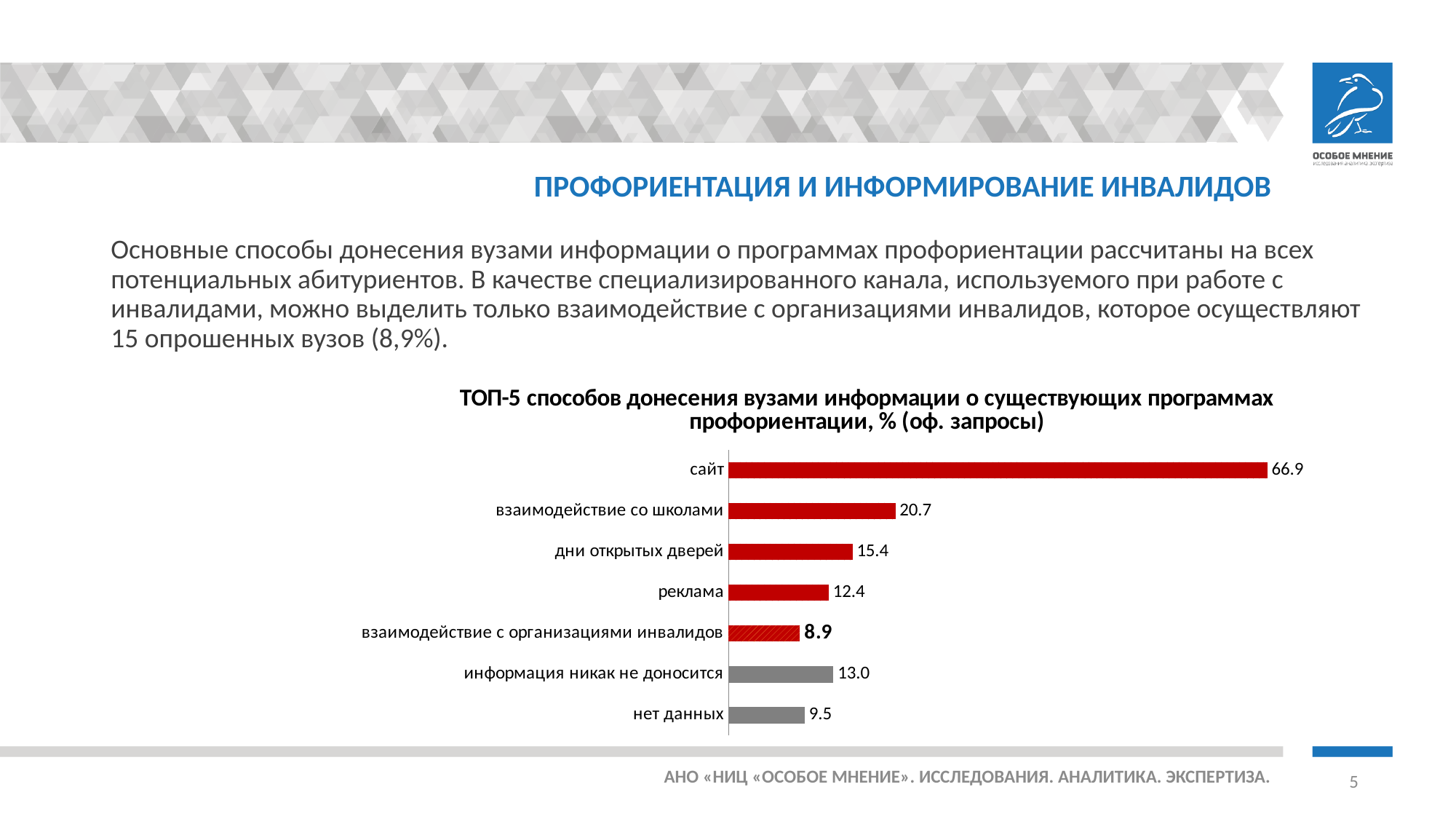
What is the value for "нет данных"? 9.5 Which category has the lowest value? взаимодействие с организациями инвалидов What is the value for "взаимодействие с организациями инвалидов"? 8.9 How many categories are shown in the chart? 7 What kind of chart is shown on the slide? bar chart What is the title of the chart? ТОП-5 способов донесения вузами информации о существующих программах профориентации, % (оф. запросы) What is the difference between the values for "сайт" and "взаимодействие со школами"? 46.2 Which is larger, the value for "информация никак не доносится" or the value for "реклама"? информация никак не доносится Which category has the highest value? сайт What is the difference between the values for "дни открытых дверей" and "реклама"? 3.0 What is the value for "сайт"? 66.9 What is the value for "взаимодействие со школами"? 20.7